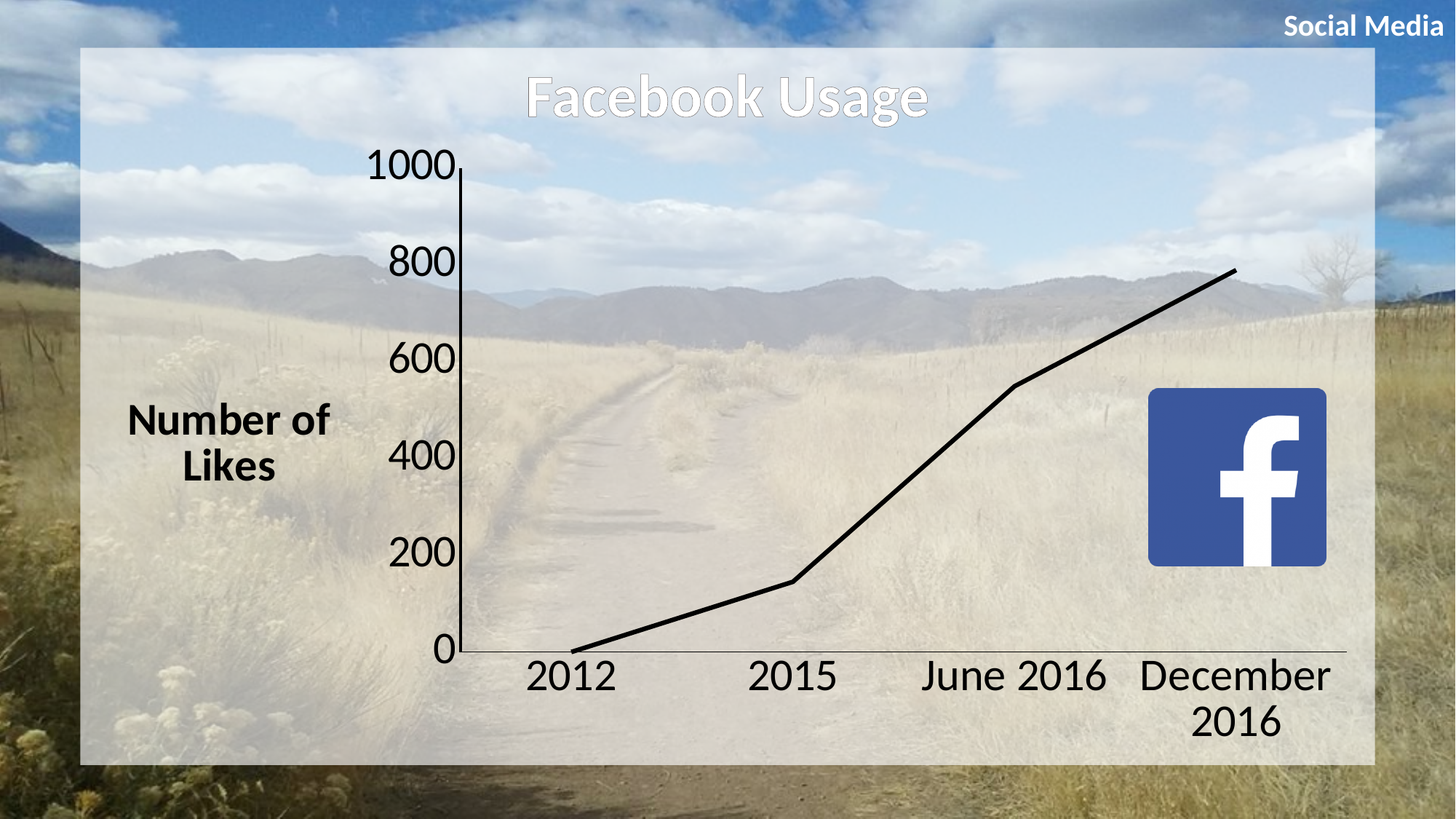
What is the label on the vertical axis of the chart? Number of Likes How many time points are plotted on the chart? 4 Which time point has the highest number of likes? December 2016 What kind of chart is shown on the slide? line chart Which has more likes, 2015 or June 2016? June 2016 Do the number of likes rise or fall from 2012 to December 2016? rise Is the number of likes for 2015 greater or less than 200? less Which time point has the lowest number of likes? 2012 Is the number of likes for December 2016 greater or less than 600? greater Is the number of likes for June 2016 greater or less than 400? greater What is the title of the chart? Facebook Usage